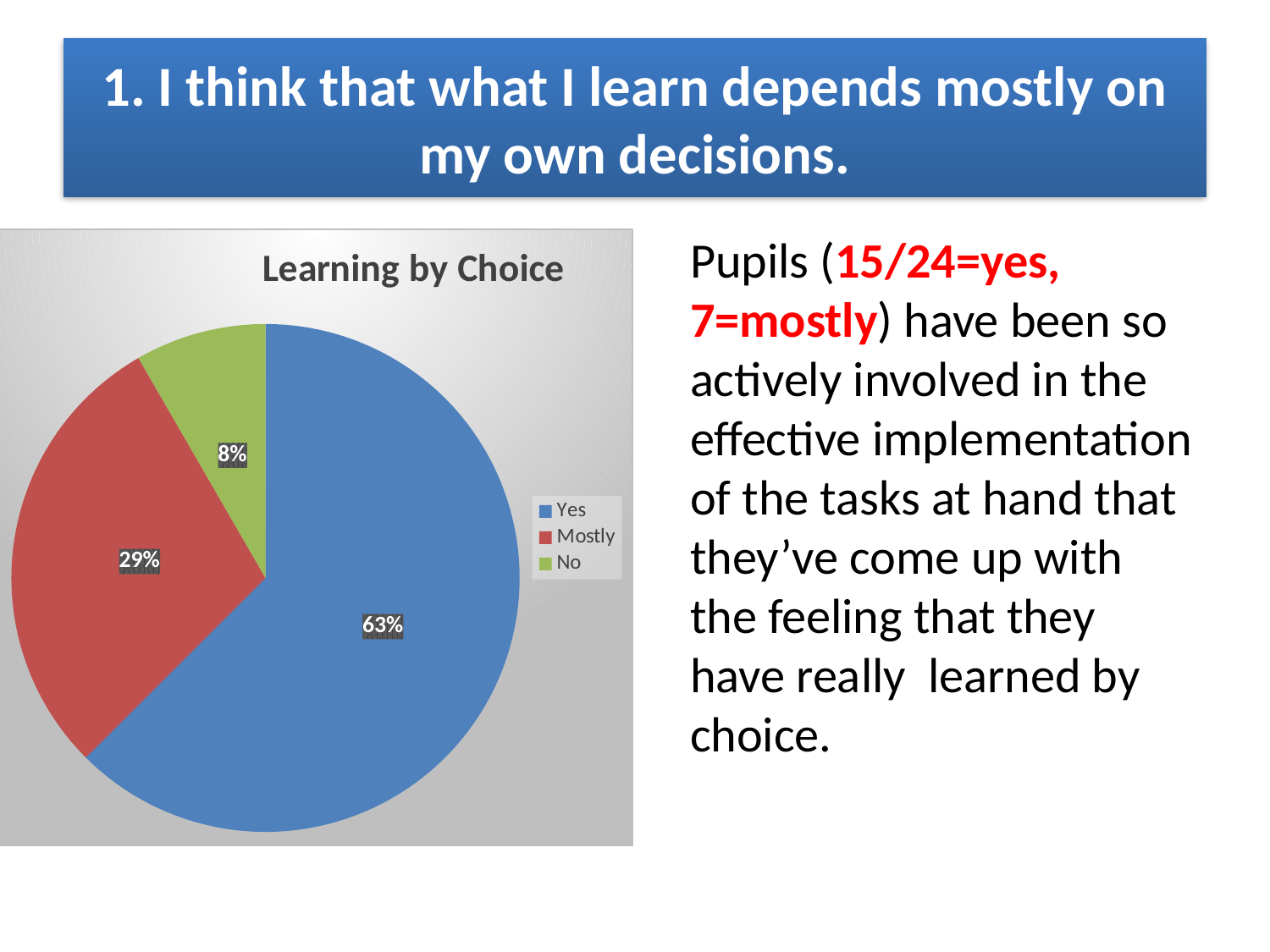
What is the difference in percentage points between the Yes and Mostly slices? 34 What is the difference in percentage points between the Mostly and No slices? 21 How many categories does the legend list? 3 What colour is the Yes slice of the pie? blue What percentage of the pie is labelled for the Mostly slice? 29% What percentage of the pie is labelled for the Yes slice? 63% What is the title of the chart? Learning by Choice Which category has the smallest share of the pie? No What type of chart is shown on the slide? pie chart What percentage of the pie is labelled for the No slice? 8% Which category has the largest share of the pie? Yes Which slice is larger, Mostly or No? Mostly